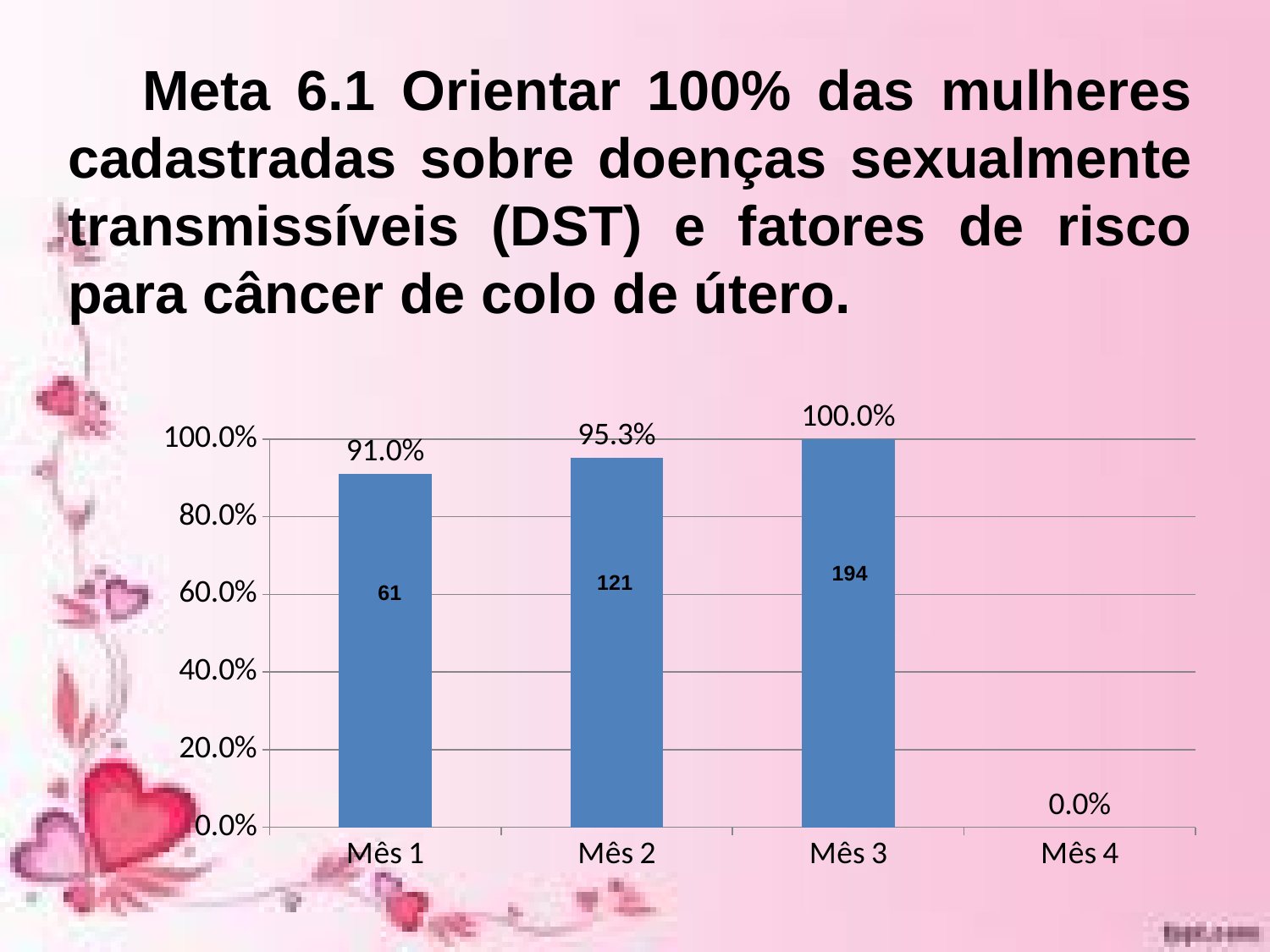
How many months (categories) are shown on the x axis? 4 What count is printed inside the bar for Mês 2? 121 What is the difference in percentage points between Mês 3 and Mês 1? 9.0% What is the percentage value shown for Mês 2? 95.3% Do the percentages rise or fall from Mês 1 to Mês 3? Rise Which month has the lowest percentage? Mês 4 What is the percentage value shown for Mês 4? 0.0% What is the percentage value shown for Mês 1? 91.0% Which month has the highest percentage? Mês 3 What kind of chart is shown on the slide? Bar chart What count is printed inside the bar for Mês 3? 194 Which is larger, the percentage for Mês 1 or for Mês 2? Mês 2